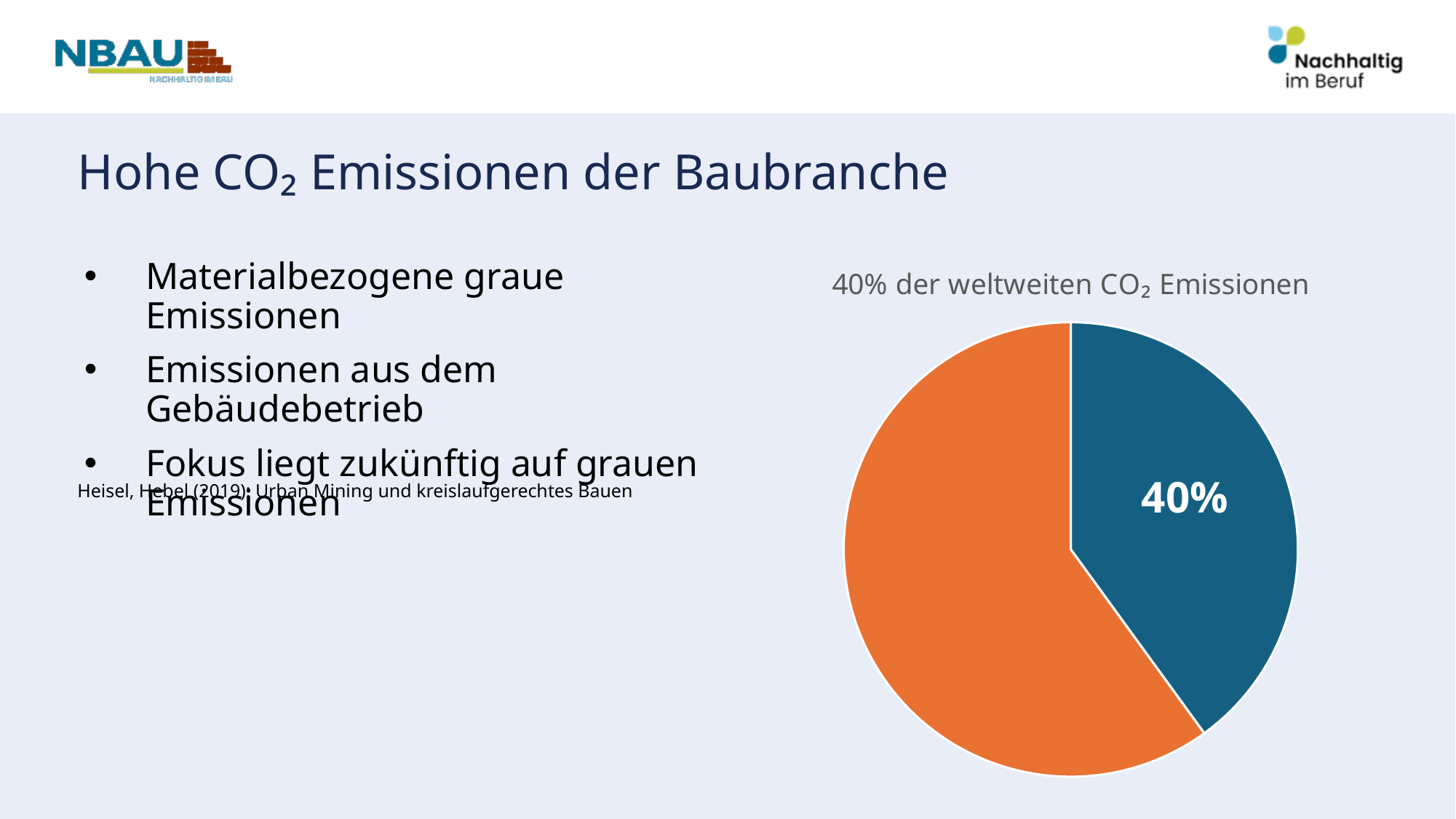
How many slices does the pie chart have? 2 Which slice of the pie chart is larger, the orange one or the blue one? orange What value is printed on the blue slice of the pie chart? 40% What kind of chart is shown on the slide? pie chart What share of the pie does the blue slice represent? 40% Which slice of the pie chart is the smallest? the blue slice (40%) What is the title of the pie chart? 40% der weltweiten CO₂ Emissionen What colour is the slice that carries the 40% label? blue